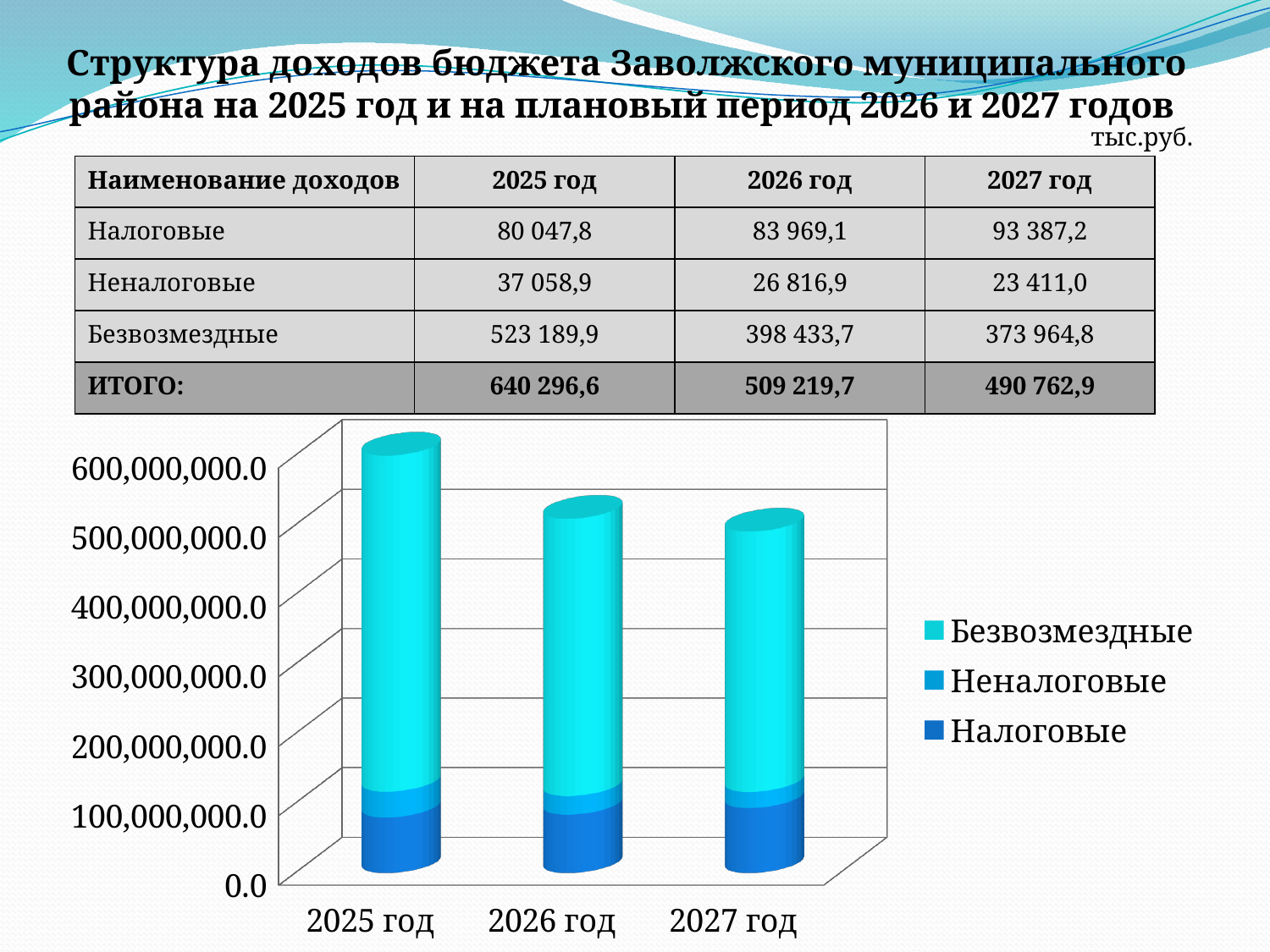
Which series forms the largest segment of each stacked bar in the chart? Безвозмездные How many series does the chart legend list? 3 Is the total bar height for 2025 год greater or less than 500,000,000.0? greater Which series is listed last in the chart legend? Налоговые How many year categories are plotted on the x axis of the chart? 3 Do the total bar heights rise or fall from 2025 год to 2027 год? fall Is the total bar height for 2027 год greater or less than 600,000,000.0? less Which year has the shortest stacked bar in the chart? 2027 год What kind of chart is shown on the slide? stacked bar chart Which year has the tallest stacked bar in the chart? 2025 год Is the total bar height for 2026 год greater or less than 400,000,000.0? greater Which is taller, the stacked bar for 2025 год or the stacked bar for 2026 год? 2025 год